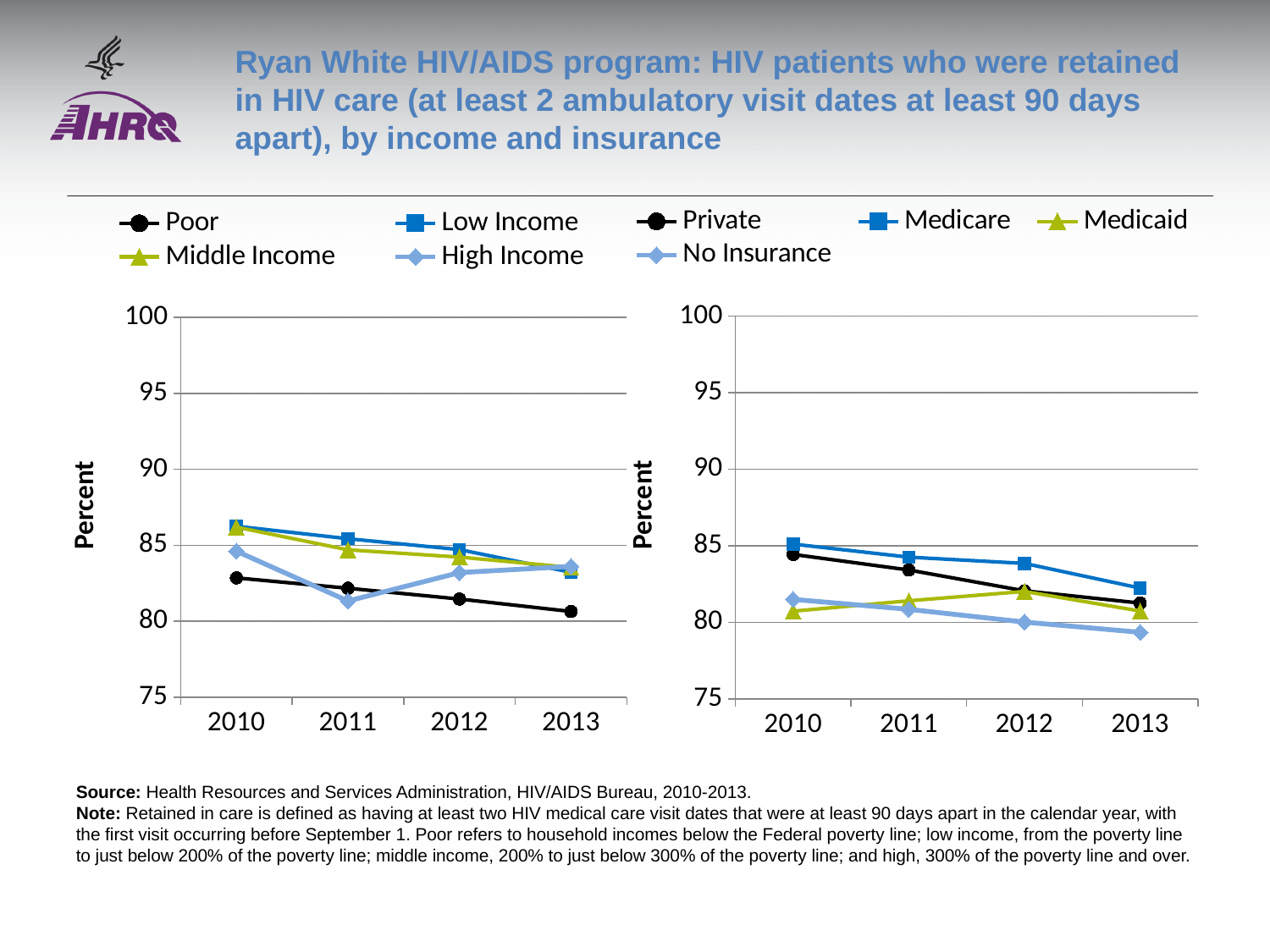
What is the label on the y axis of the charts? Percent In the left chart (by income), is the value for Low Income in 2010 greater or less than 85? greater In the right chart (by insurance), is the value for No Insurance in 2013 greater or less than 80? less In the left chart (by income), does the Poor line rise or fall from 2010 to 2013? Fall In the left chart (by income), which is larger in 2010: Low Income or Poor? Low Income How many series does the legend list for the right chart (by insurance)? 4 How many years are plotted along the x axis of the left chart (by income)? 4 In the left chart (by income), which income group has the lowest value in 2013? Poor What kind of chart is the left chart (by income)? Line chart In the right chart (by insurance), which insurance group has the lowest value in 2013? No Insurance In the right chart (by insurance), does the No Insurance line rise or fall from 2010 to 2013? Fall How many series does the legend list for the left chart (by income)? 4